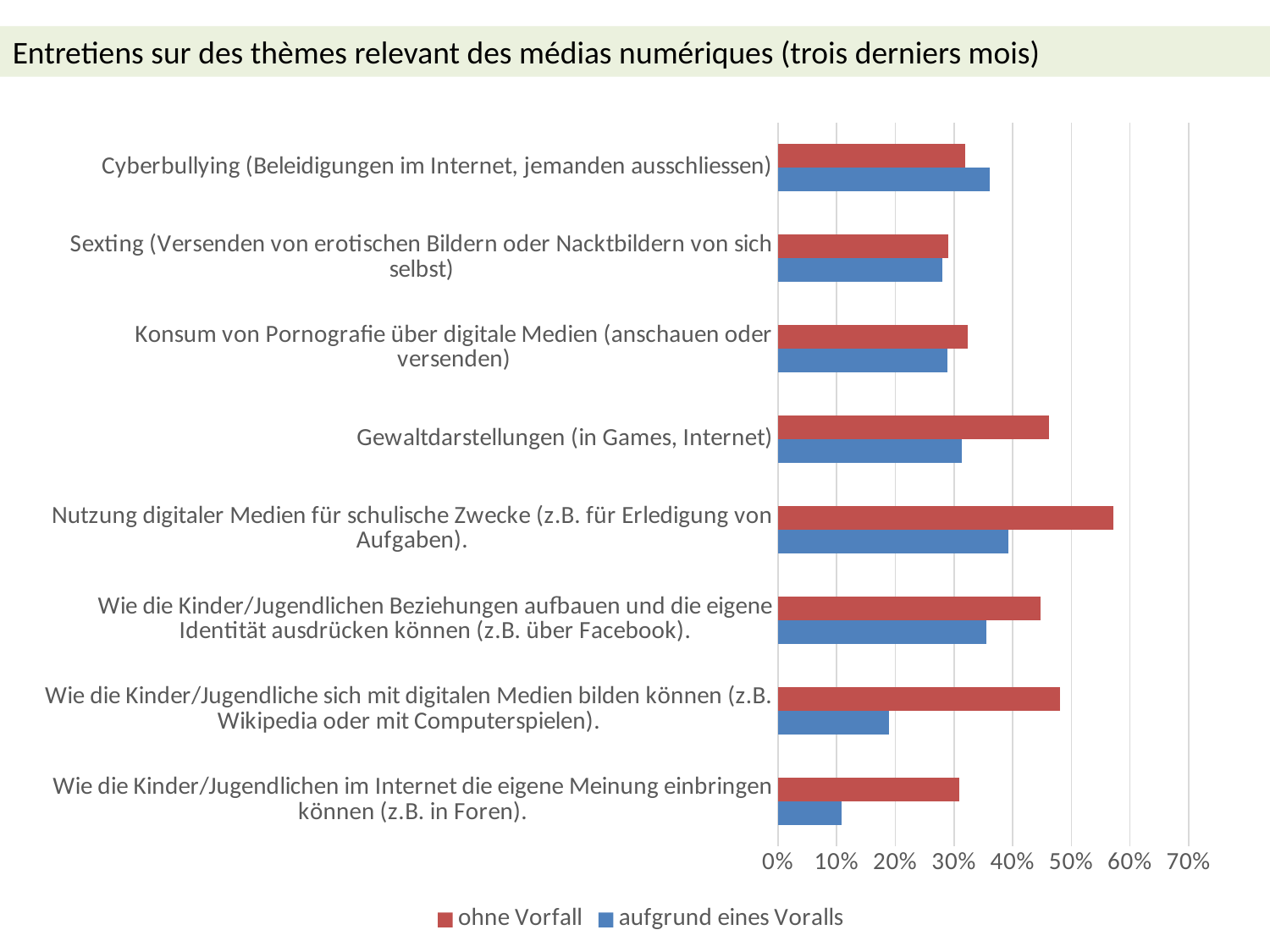
Which category has the lowest value for the 'aufgrund eines Voralls' series? Wie die Kinder/Jugendlichen im Internet die eigene Meinung einbringen können (z.B. in Foren). What kind of chart is shown on the slide? bar chart Is the 'ohne Vorfall' value for 'Nutzung digitaler Medien für schulische Zwecke' greater or less than 50%? greater Which category has the highest value for the 'ohne Vorfall' series? Nutzung digitaler Medien für schulische Zwecke (z.B. für Erledigung von Aufgaben). For 'Gewaltdarstellungen (in Games, Internet)', which series has the larger value: 'ohne Vorfall' or 'aufgrund eines Voralls'? ohne Vorfall For 'Cyberbullying', which series has the larger value: 'ohne Vorfall' or 'aufgrund eines Voralls'? aufgrund eines Voralls Is the 'aufgrund eines Voralls' value for 'Cyberbullying' greater or less than 30%? greater Is the 'aufgrund eines Voralls' value for 'Wie die Kinder/Jugendlichen im Internet die eigene Meinung einbringen können' greater or less than 20%? less How many series does the legend list? 2 What is the title of the slide? Entretiens sur des thèmes relevant des médias numériques (trois derniers mois) What colour represents the 'ohne Vorfall' series? red How many categories are plotted on the chart? 8